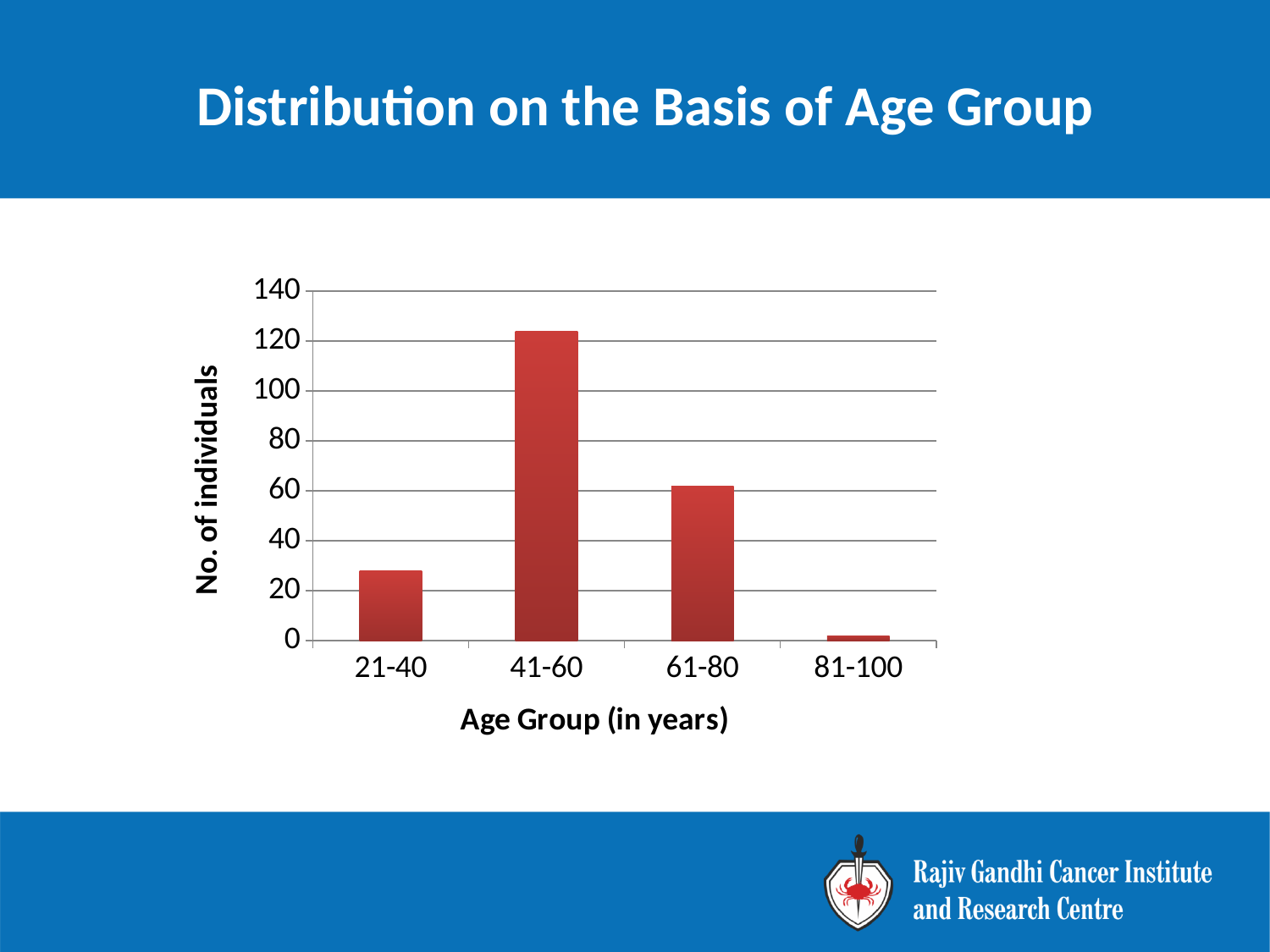
What is the title of the slide containing the chart? Distribution on the Basis of Age Group Is the value for the 41-60 age group greater or less than 100? greater Which age group has the highest number of individuals? 41-60 Is the value for the 21-40 age group greater or less than 40? less Which age group has the lowest number of individuals? 81-100 How many age groups are shown on the x axis? 4 Which age group has more individuals, 21-40 or 61-80? 61-80 What is the label of the y axis? No. of individuals What kind of chart is shown on the slide? bar chart Is the value for the 61-80 age group greater or less than 80? less